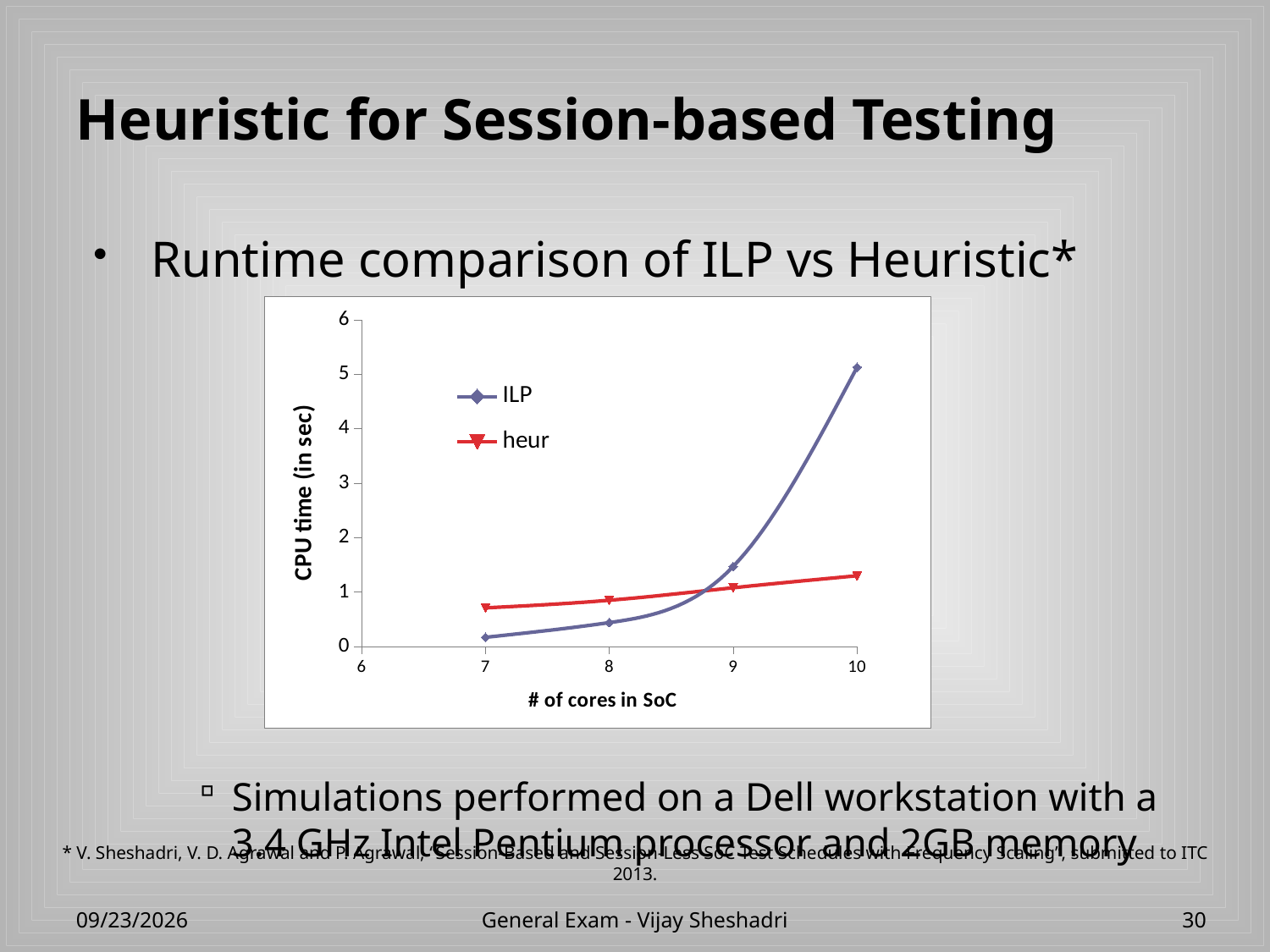
What are the two series named in the chart legend? ILP and heur Does the CPU time for ILP rise or fall as the number of cores in the SoC increases? rise What is the label of the chart's y axis? CPU time (in sec) How many data points are plotted for the ILP series? 4 What kind of chart is shown on the slide? line chart At 7 cores, which series has the higher CPU time, ILP or heur? heur Is the CPU time for ILP at 10 cores greater or less than 4? greater At which number of cores does the ILP series reach its highest CPU time? 10 Is the CPU time for heur at 10 cores greater or less than 2? less At 10 cores, which series has the higher CPU time, ILP or heur? ILP How many series does the chart legend list? 2 At which number of cores does the ILP series have its lowest CPU time? 7